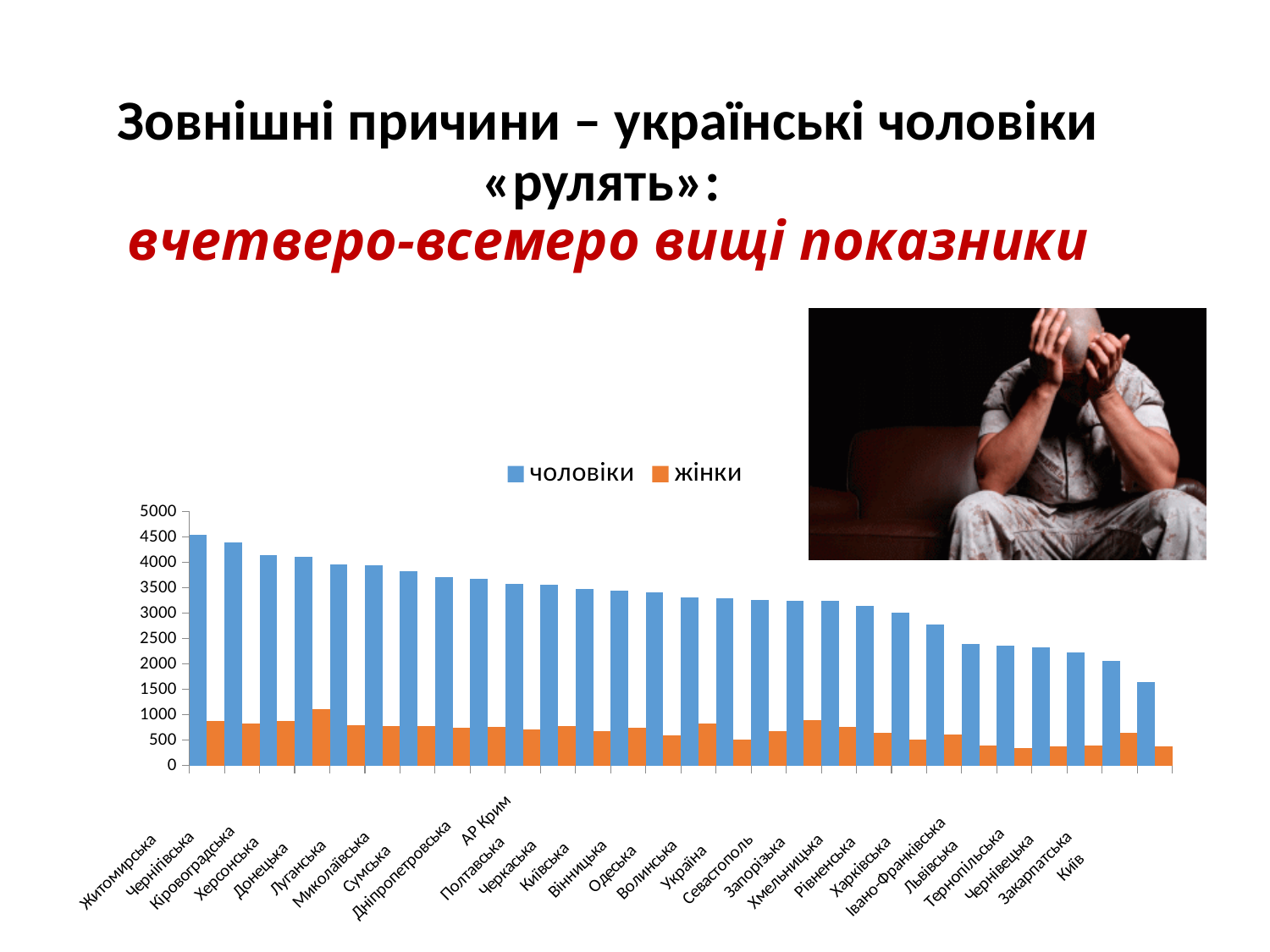
How many series does the legend list? 2 Is the value for чоловіки in Київ greater or less than 2000? less How many categories are shown along the x axis? 28 Which category has the lowest value for чоловіки? Київ Which is larger: the чоловіки value for Житомирська or for Київ? Житомирська What are the two series named in the legend? чоловіки and жінки Which category has the highest value for жінки? Херсонська Is the value for жінки in Луганська greater or less than 1000? less Do the чоловіки values rise or fall moving left to right along the x axis? fall Which category has the highest value for чоловіки? Житомирська Is the value for чоловіки in Житомирська greater or less than 4000? greater What kind of chart is shown on the slide? bar chart